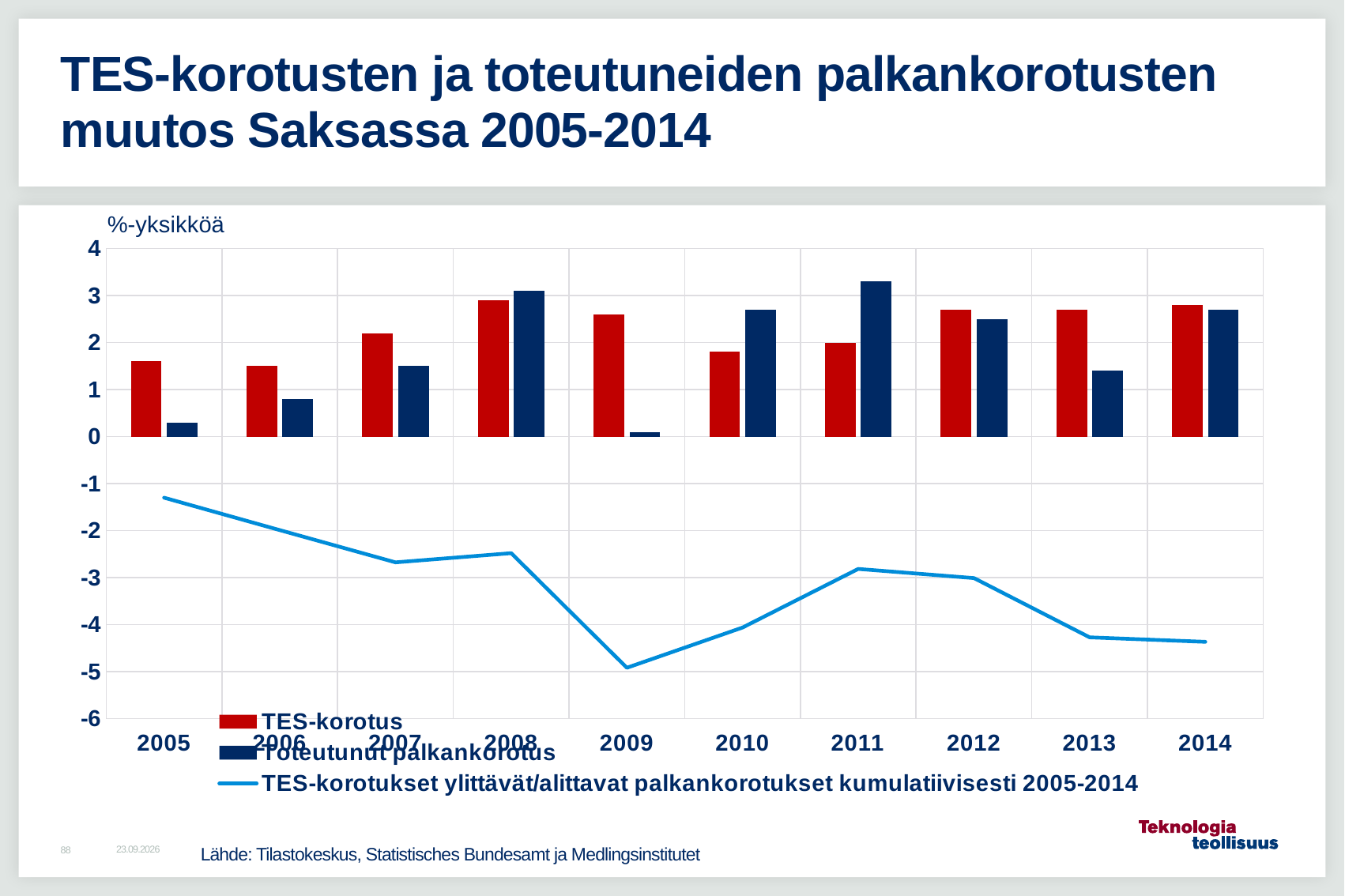
Is the value for TES-korotus in 2008 greater or less than 2? greater In which year is the line 'TES-korotukset ylittävät/alittavat palkankorotukset kumulatiivisesti 2005-2014' at its lowest? 2009 In 2005, which is larger: TES-korotus or Toteutunut palkankorotus? TES-korotus What kind of chart is shown on the slide? A combined bar and line chart What colour are the TES-korotus bars? Red Is the value for Toteutunut palkankorotus in 2009 greater or less than 1? less What unit label is shown above the vertical axis? %-yksikköä How many years are shown on the x axis? 10 Is the value of the cumulative line in 2009 greater or less than -4? less Does the cumulative line rise or fall from 2005 to 2009? Fall In 2011, which is larger: TES-korotus or Toteutunut palkankorotus? Toteutunut palkankorotus How many series does the legend list? 3